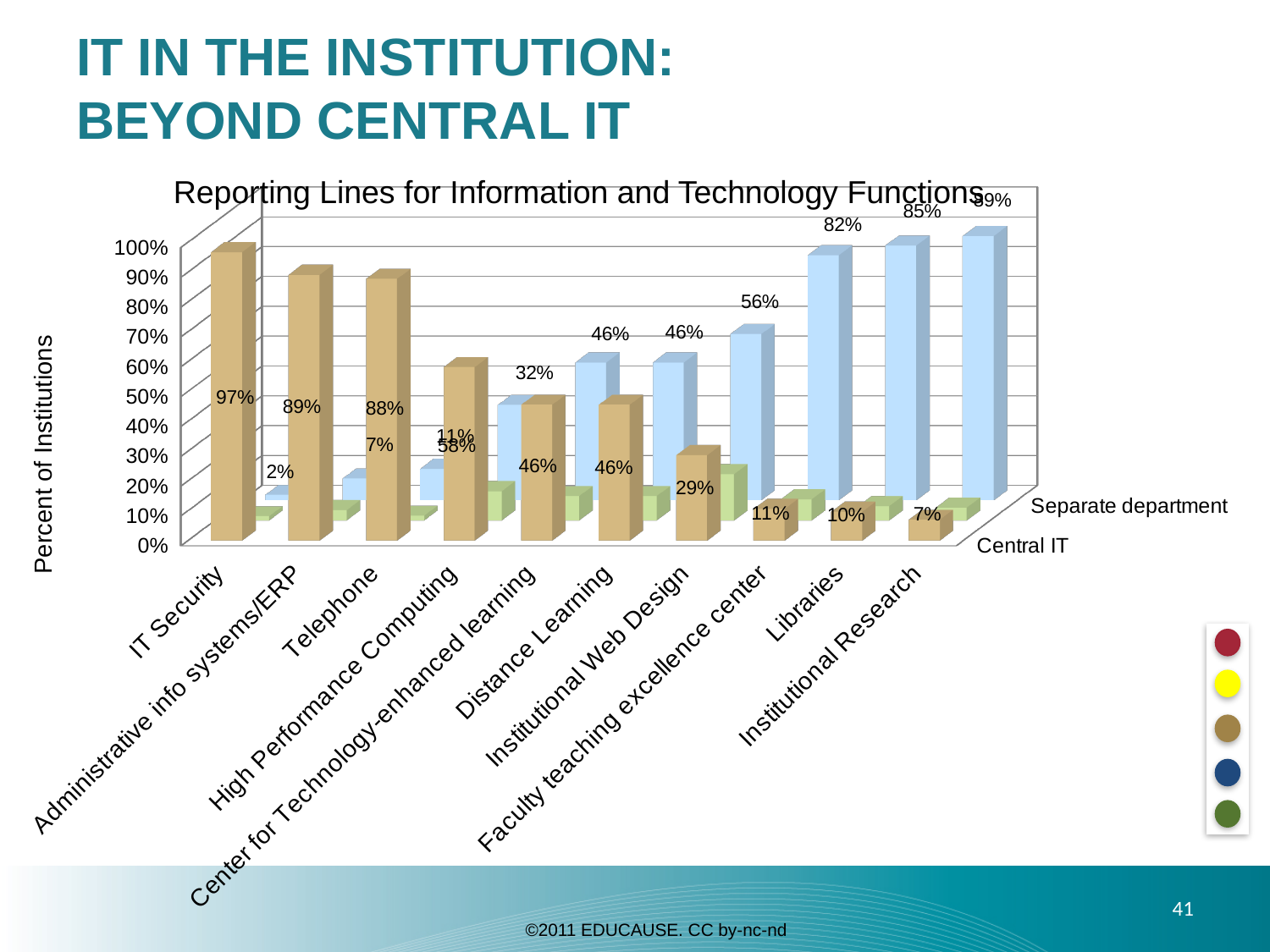
What is the Central IT value for Telephone? 88% How many percentage points higher is the Central IT value for IT Security than for Administrative info systems/ERP? 8 percentage points What is the Separate department value for Libraries? 85% Which function has the highest Separate department percentage? Institutional Research How many functions are shown on the x axis of the chart? 10 For Institutional Web Design, which is larger: the Central IT value or the Separate department value? Separate department Which function has the lowest Central IT percentage? Institutional Research What type of chart is shown on the slide? Bar chart What percentage of institutions report IT Security to Central IT? 97% What is the Separate department value for Institutional Research? 89% Do the Central IT values rise or fall moving from left to right across the functions? Fall Which function has the highest Central IT percentage? IT Security